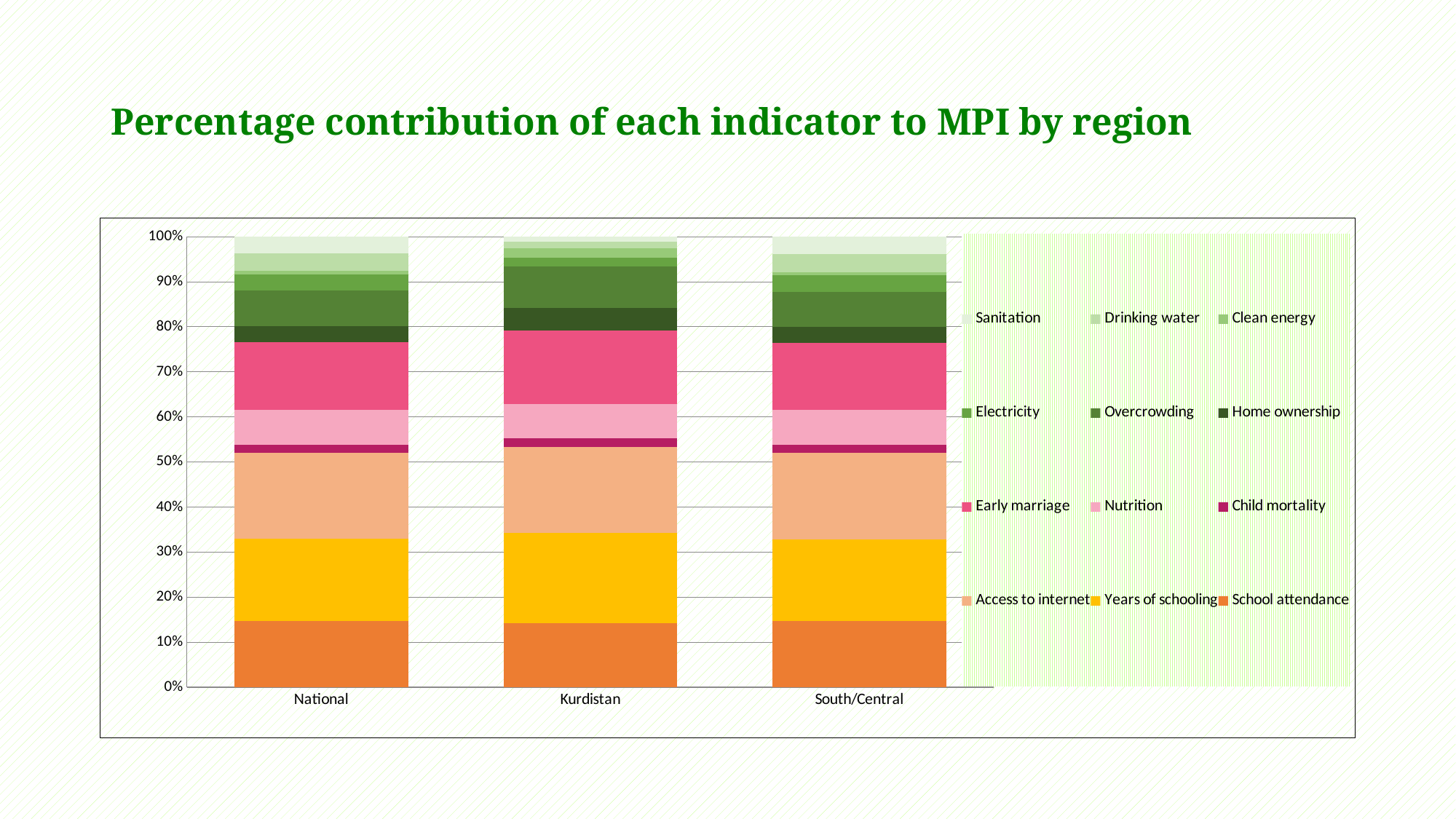
How many regions (categories) are shown on the x axis? 3 How many indicators (series) does the legend list? 12 What kind of chart is shown on the slide? Stacked bar chart What is the total of the stacked bar for National? 100% Is the School attendance contribution for National greater or less than 20%? less Which region has the larger Overcrowding contribution, National or Kurdistan? Kurdistan Which indicator is shown at the bottom of each stacked bar? School attendance Is the School attendance contribution for South/Central greater or less than 20%? less Which region has the larger Home ownership contribution, Kurdistan or South/Central? Kurdistan What is the title of the chart? Percentage contribution of each indicator to MPI by region What is the total of the stacked bar for Kurdistan? 100% Is the School attendance contribution for Kurdistan greater or less than 10%? greater